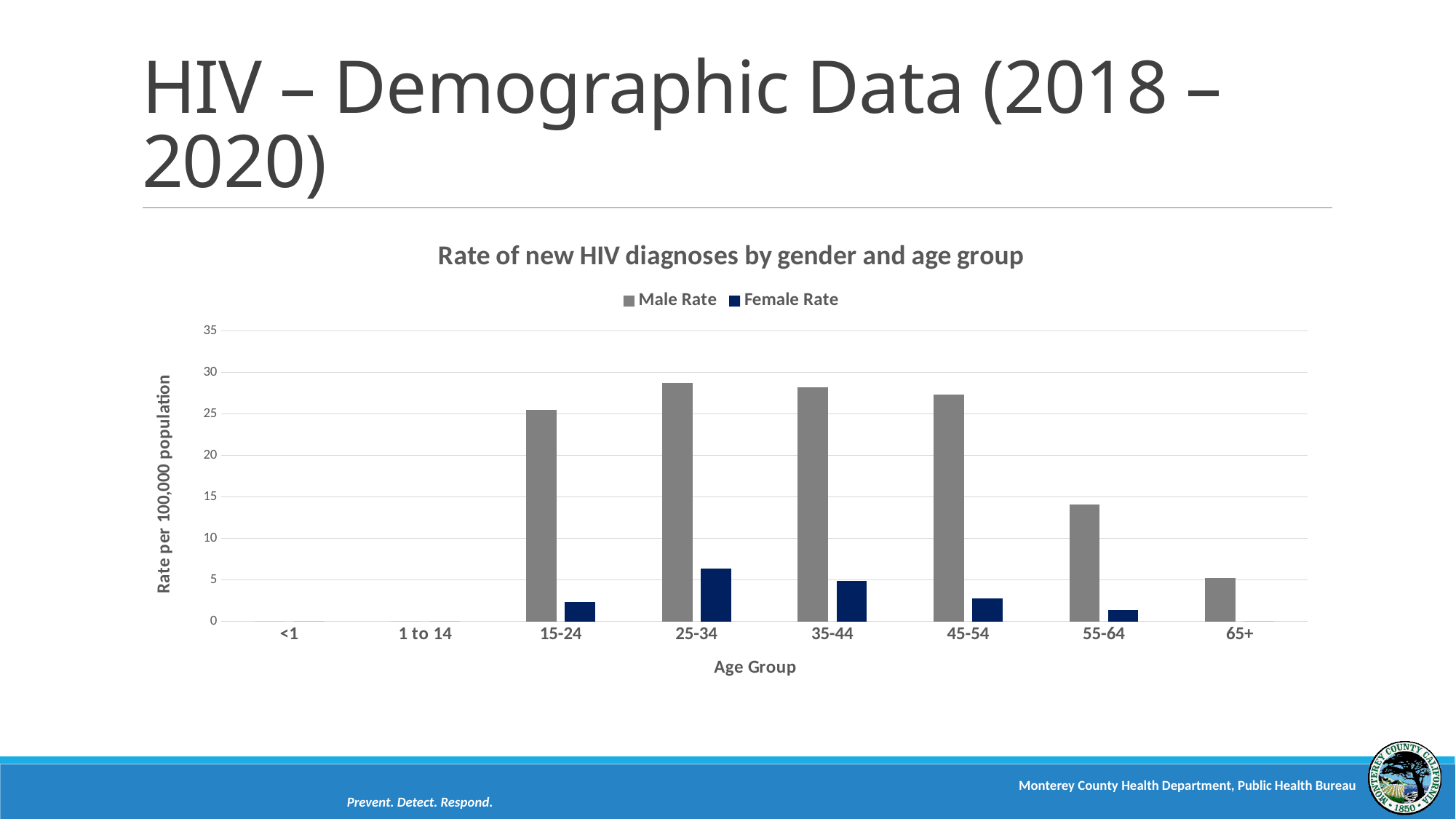
Is the Female Rate for the 15-24 age group greater or less than 5? less What is the label of the y axis? Rate per 100,000 population What kind of chart is shown on the slide? Bar chart Which is larger, the Male Rate for 15-24 or the Male Rate for 55-64? Male Rate for 15-24 Is the Male Rate for the 25-34 age group greater or less than 30? less How many age groups are shown on the x axis? 8 Is the Female Rate for the 25-34 age group greater or less than 5? greater Which age group has the highest Female Rate? 25-34 Does the Male Rate rise or fall across the age groups from 45-54 to 65+? Fall How many series does the legend list? 2